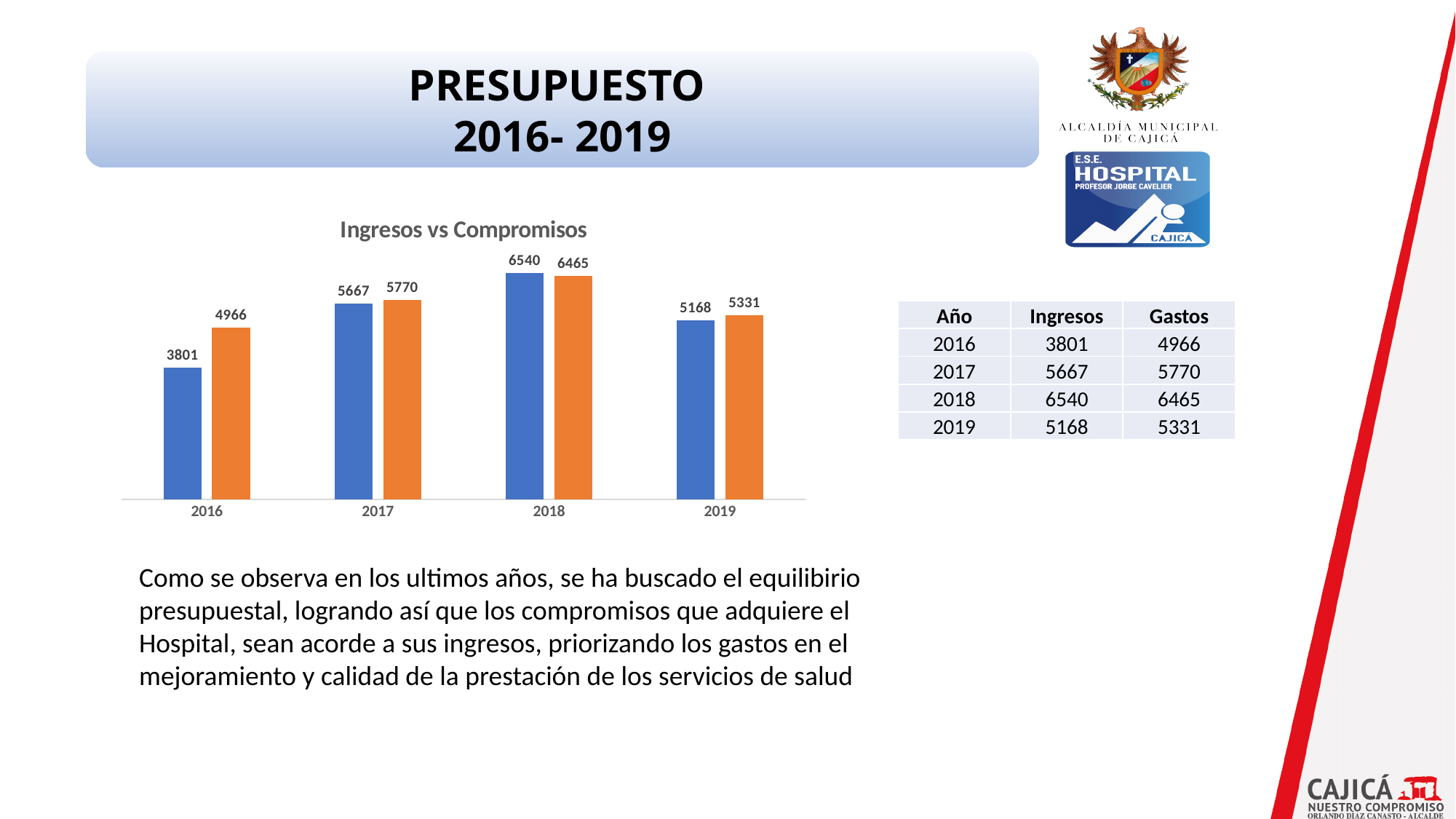
What is the Gastos (orange bar) value for 2019 in the chart? 5331 What type of chart is shown on the slide? Bar chart What is the difference between Gastos and Ingresos in 2016? 1165 How many data series (bars per year) are plotted in the chart? 2 By how much did Ingresos fall from 2018 to 2019? 1372 In 2018, which is larger: Ingresos or Gastos? Ingresos In which year is the Ingresos (blue bar) value highest? 2018 What is the Gastos (orange bar) value for 2017? 5770 How many years are shown on the x axis of the chart? 4 Do the Ingresos (blue bar) values rise or fall from 2016 to 2018? Rise In which year is the Ingresos (blue bar) value lowest? 2016 What is the Ingresos (blue bar) value for 2016 in the Ingresos vs Compromisos chart? 3801